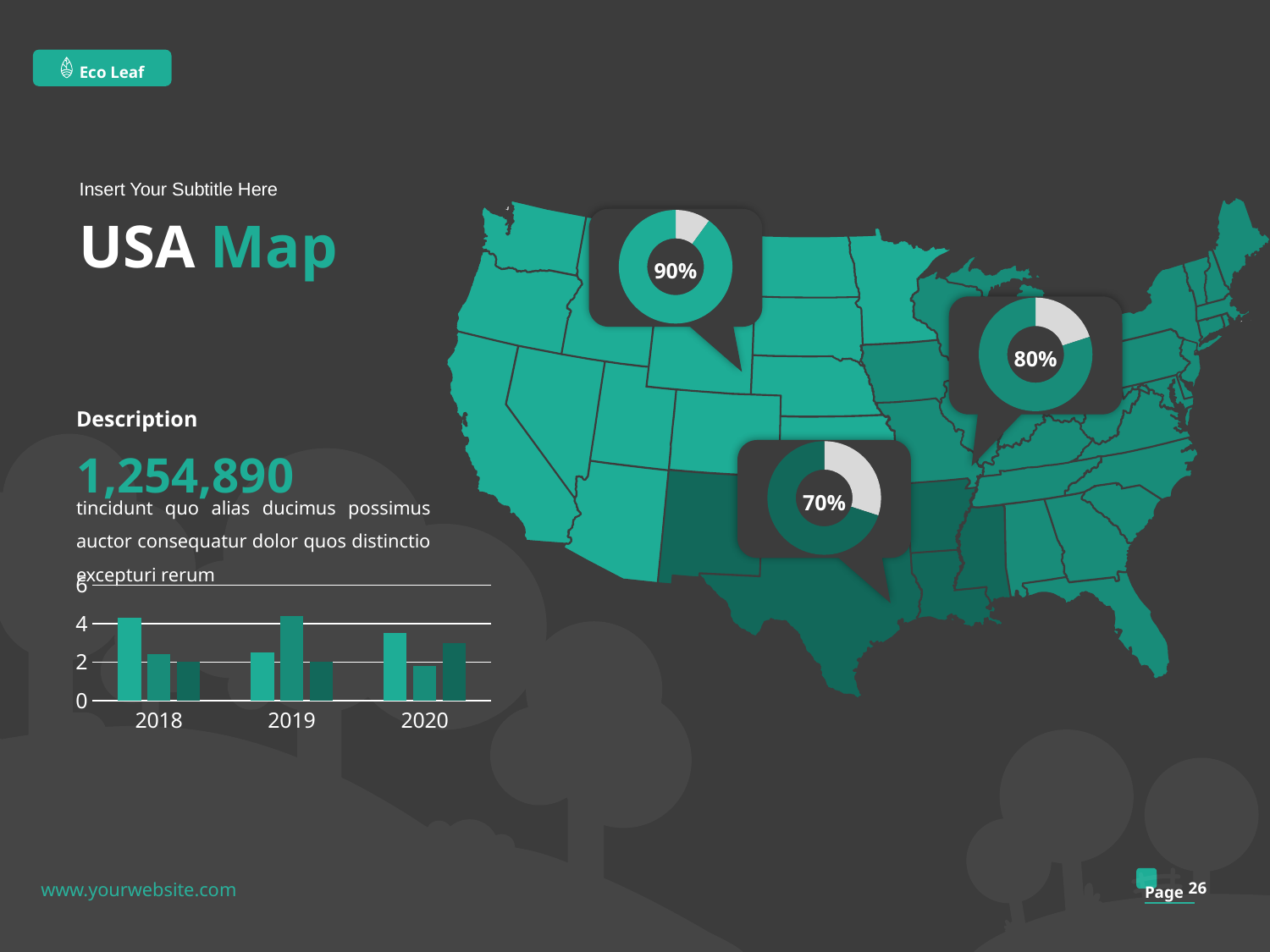
Which of the three donut charts on the USA map shows the highest percentage? the top-left one, 90% How many year categories are shown on the x axis of the bar chart at the bottom left? 3 What kind of chart is shown at the bottom left of the slide, below the description text? bar chart In the bar chart at the bottom left, is the value of the first (leftmost) bar for 2019 greater or less than 2? greater In the bar chart at the bottom left, is the value of the tallest bar for 2020 greater or less than 4? less In the bar chart at the bottom left, is the value of the tallest bar for 2019 greater or less than 4? greater In the bar chart at the bottom left, which is larger for 2019: the first bar or the middle bar? the middle bar What percentage is shown in the donut chart near the bottom centre of the USA map? 70% How many bars are plotted for each year in the bar chart at the bottom left? 3 What percentage is shown in the donut chart at the top left of the USA map? 90% What percentage is shown in the donut chart on the right side of the USA map? 80%